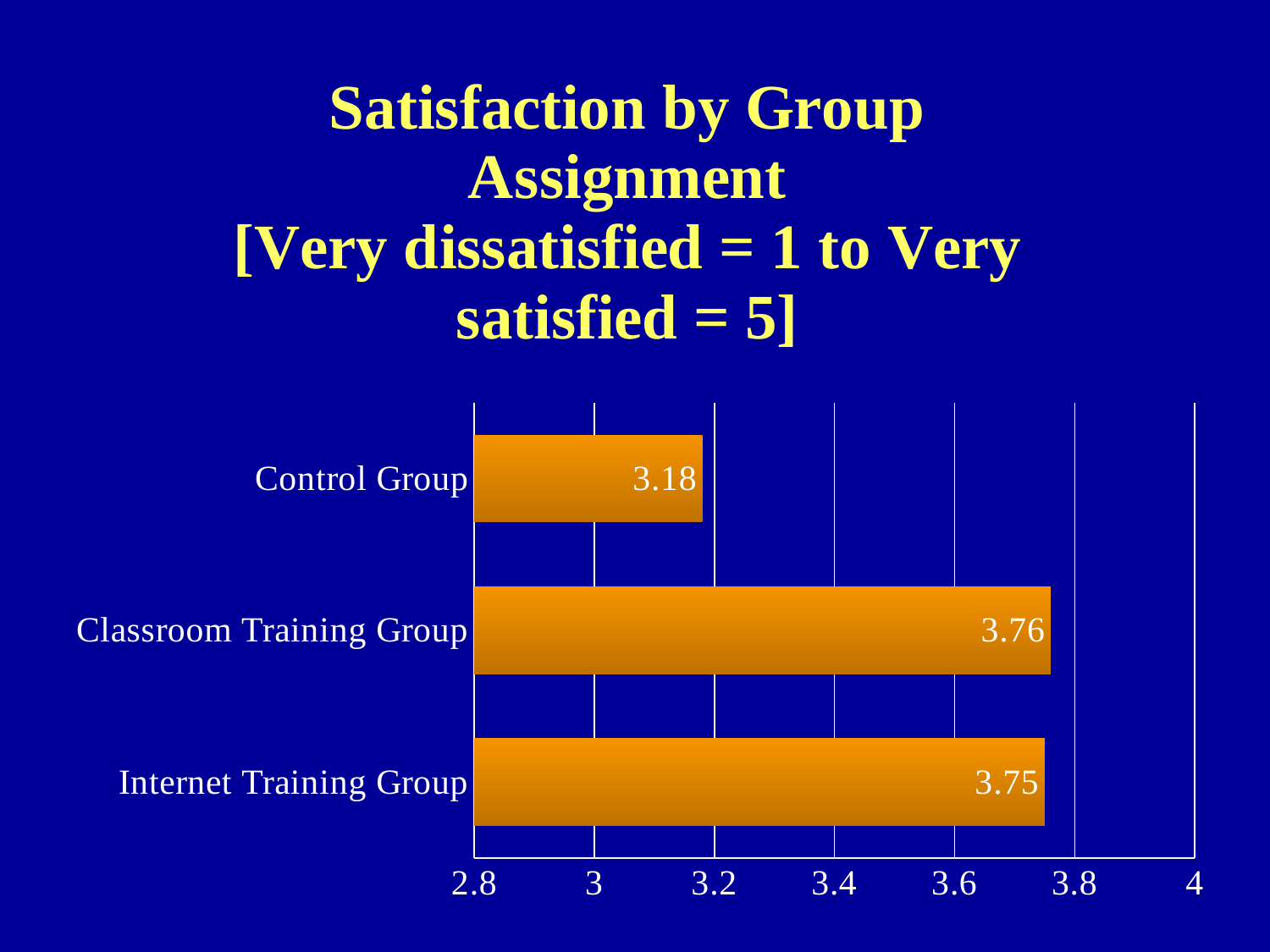
Which group has the lowest satisfaction value? Control Group Which group has the highest satisfaction value? Classroom Training Group How many groups are shown in the chart? 3 What is the satisfaction value for the Internet Training Group? 3.75 What is the difference between the Internet Training Group and the Control Group satisfaction values? 0.57 What is the satisfaction value for the Control Group? 3.18 Is the value for the Control Group greater or less than 3.2? less What is the title of the chart on the slide? Satisfaction by Group Assignment [Very dissatisfied = 1 to Very satisfied = 5] Which is larger, the satisfaction value for the Internet Training Group or the Control Group? Internet Training Group What is the difference between the Classroom Training Group and the Control Group satisfaction values? 0.58 What is the satisfaction value for the Classroom Training Group? 3.76 What kind of chart is shown on the slide? bar chart